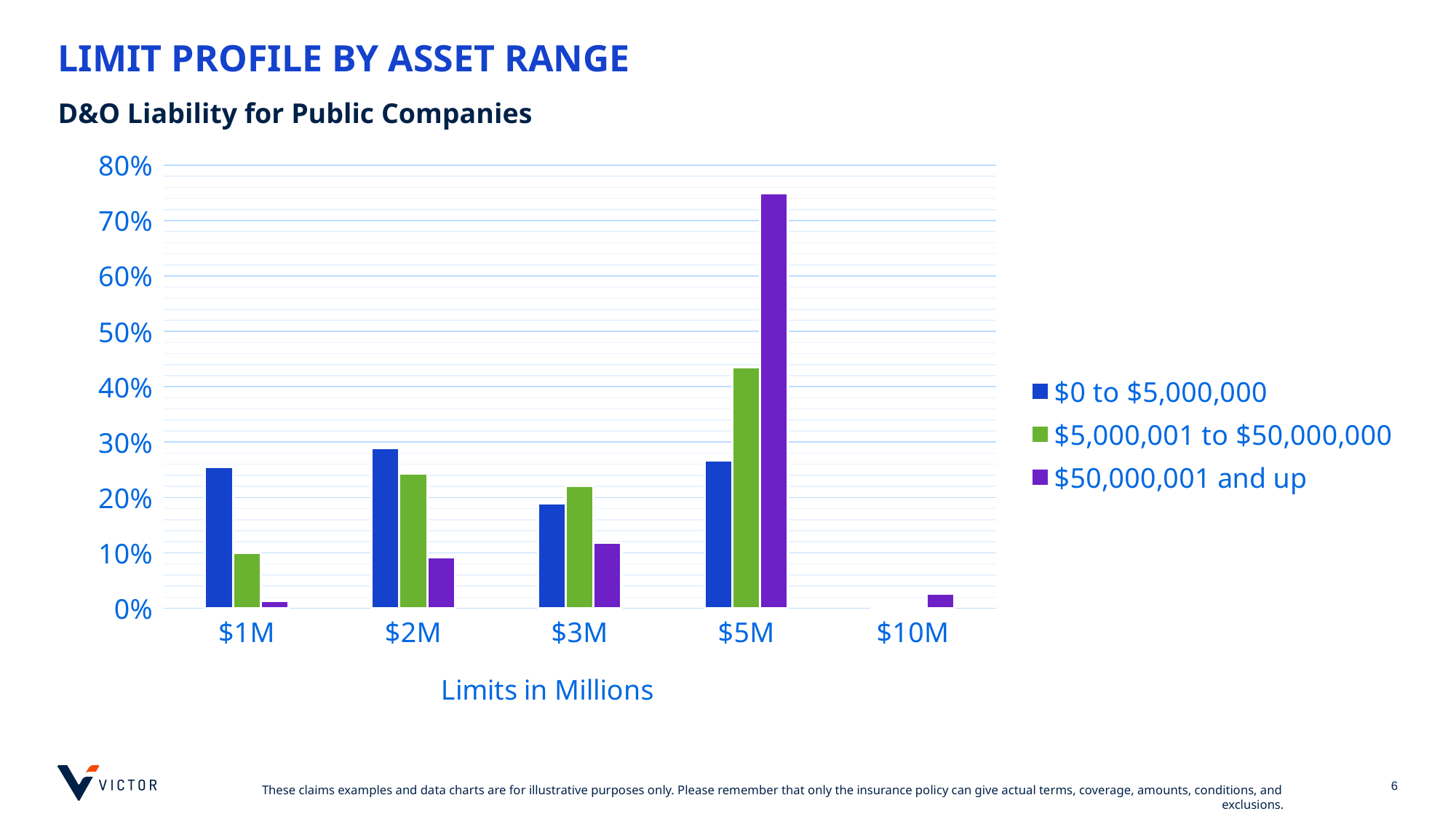
How many limit categories are shown on the x axis? 5 What is the title of the x axis? Limits in Millions At the $1M limit, which series has the larger value: $0 to $5,000,000 or $5,000,001 to $50,000,000? $0 to $5,000,000 Which limit has the highest value for the $5,000,001 to $50,000,000 series? $5M At the $5M limit, which series has the larger value: $5,000,001 to $50,000,000 or $50,000,001 and up? $50,000,001 and up Is the value for $5,000,001 to $50,000,000 at the $3M limit greater or less than 30%? less Is the value for $0 to $5,000,000 at the $3M limit greater or less than 10%? greater How many series does the legend list? 3 Which limit has the highest value for the $50,000,001 and up series? $5M What kind of chart is shown on the slide? bar chart Is the value for $0 to $5,000,000 at the $2M limit greater or less than 20%? greater